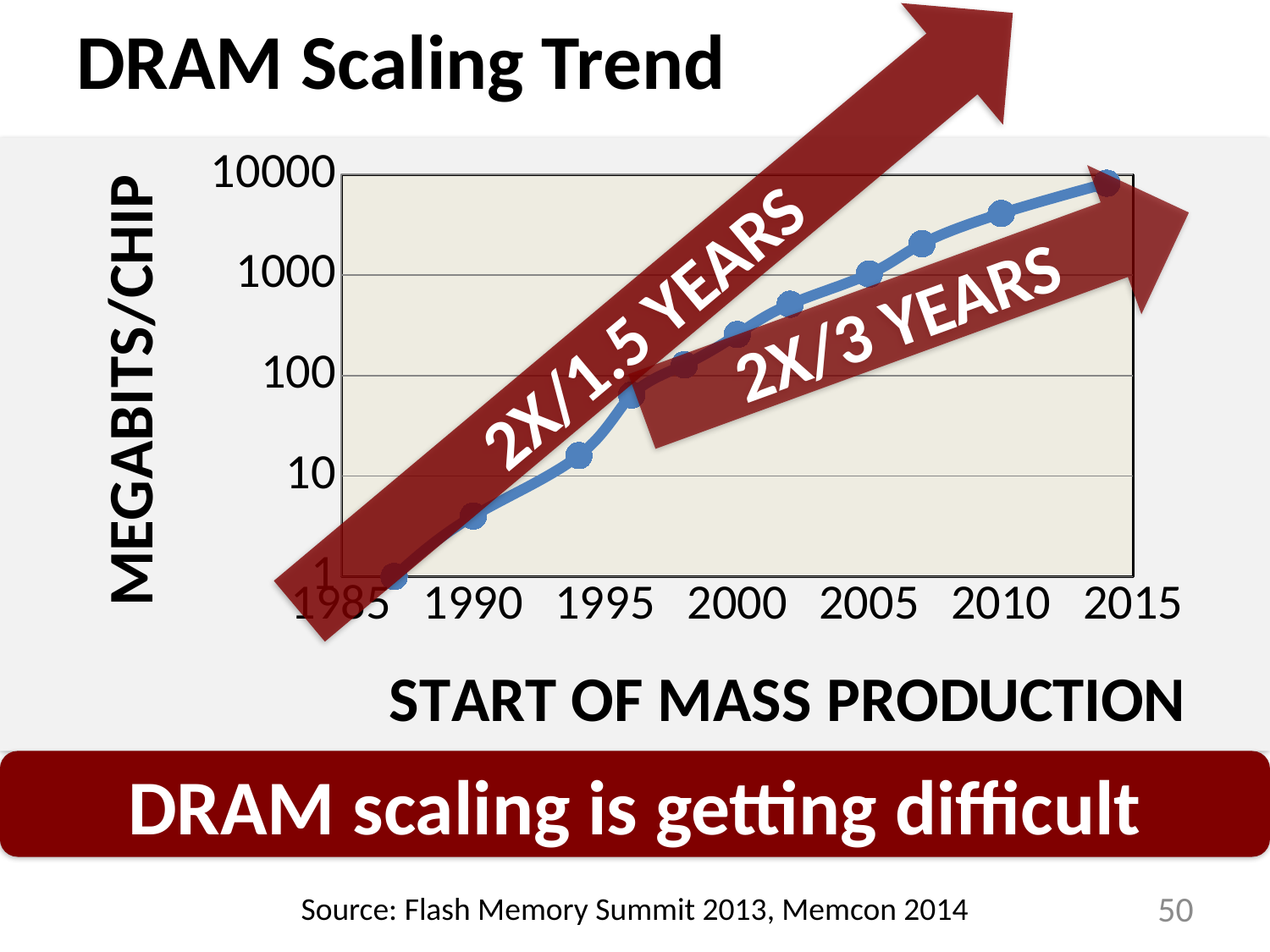
What is the label on the x axis of the chart? START OF MASS PRODUCTION Which point has the highest megabits/chip value, the one at 2010 or the one at 2014? 2014 What is the label on the y axis of the chart? MEGABITS/CHIP Is the megabits/chip value for the point at 1990 greater or less than 10? less Is the megabits/chip value for the point at 2007 greater or less than 1000? greater Which point has the lower megabits/chip value, the one at 1990 or the one at 2000? 1990 What kind of chart is shown on the slide? line chart Do the megabits/chip values rise or fall as the start of mass production year increases? rise Is the megabits/chip value for the point at 2000 greater or less than 100? greater